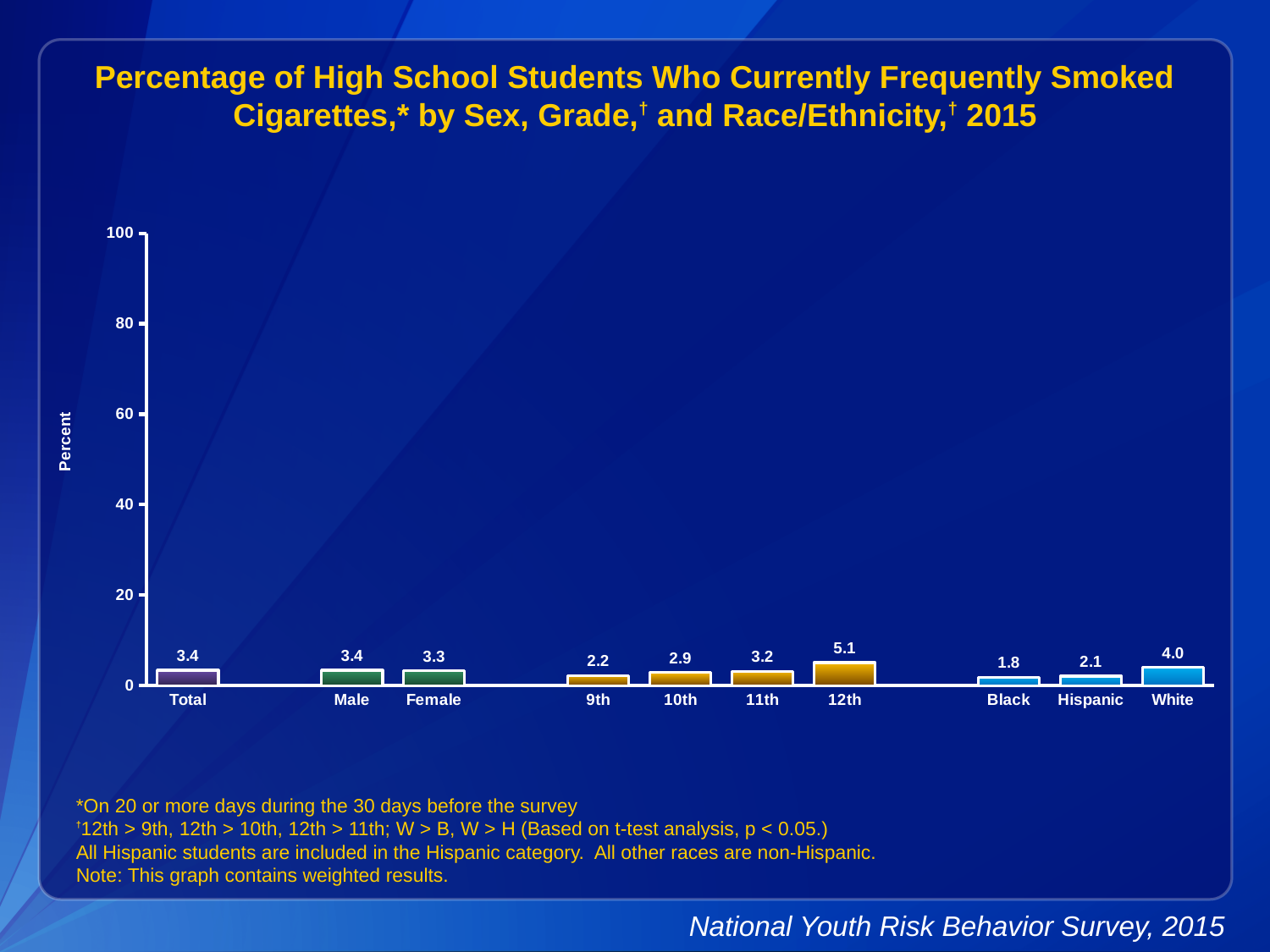
Do the values rise or fall from 9th grade to 12th grade? rise What is the value for 12th grade? 5.1 Which category has the lowest value? Black What is the difference between the values for 12th and 9th grade? 2.9 Which category has the highest value? 12th What kind of chart is this? bar chart What is the value for Black students? 1.8 What is the value for Total? 3.4 Which is larger, the value for Hispanic or the value for White? White What is the difference between the values for White and Black students? 2.2 How many categories are shown on the x axis? 10 Is the value for 12th grade greater or less than 20? less